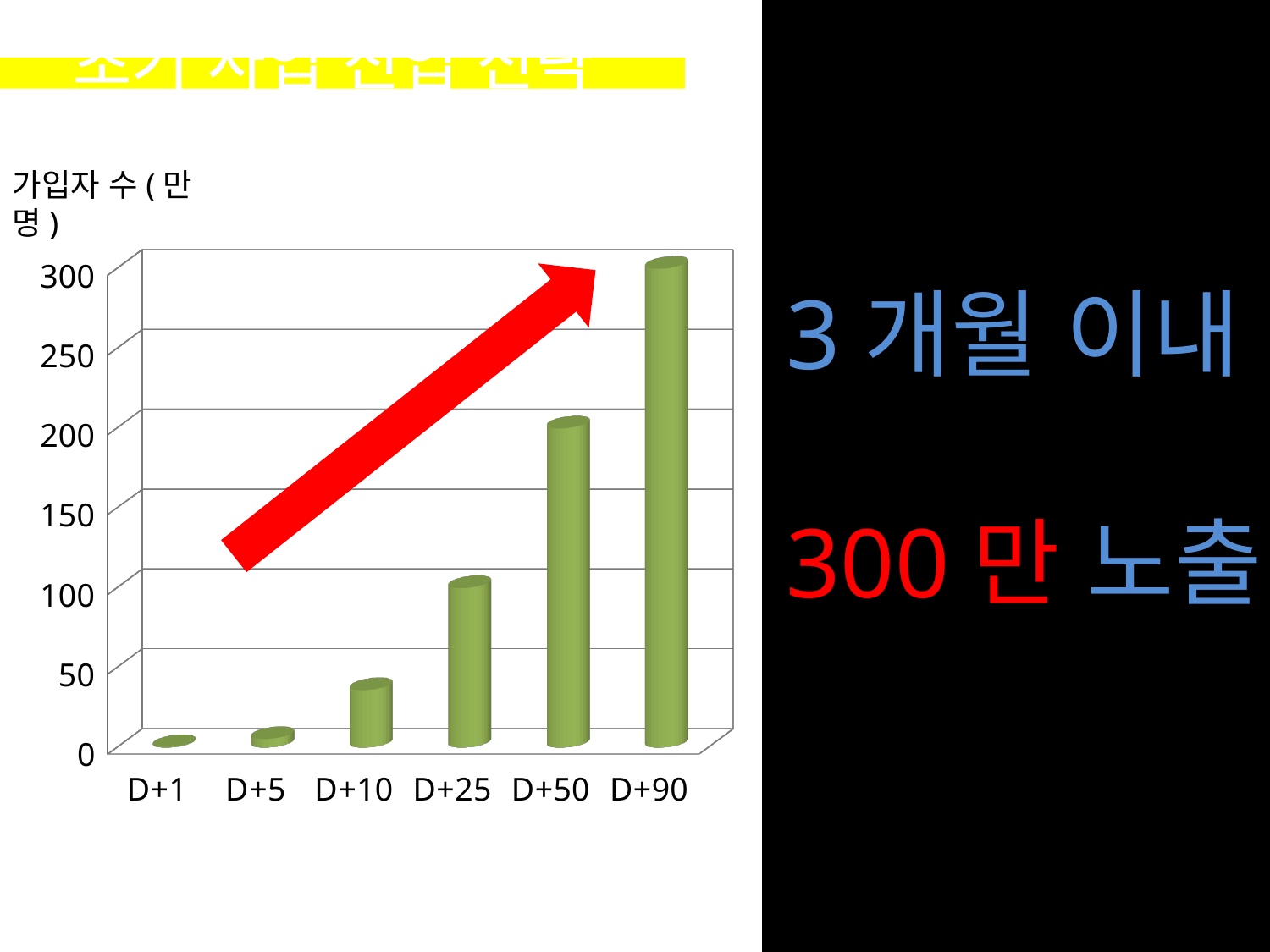
Which category has the lowest value in the chart? D+1 Which is larger, the value for D+25 or the value for D+50? D+50 What is the value for D+25 in the chart? 100 Which category has the highest value in the chart? D+90 Is the value for D+10 greater or less than 50? less What is the value for D+90 in the chart? 300 Is the value for D+5 greater or less than 50? less Do the values rise or fall from D+1 to D+90 along the x axis? rise How many categories are shown on the x axis of the chart? 6 What is the label of the vertical axis of the chart? 가입자 수 (만 명) What kind of chart is shown on the slide? bar chart What is the value for D+50 in the chart? 200